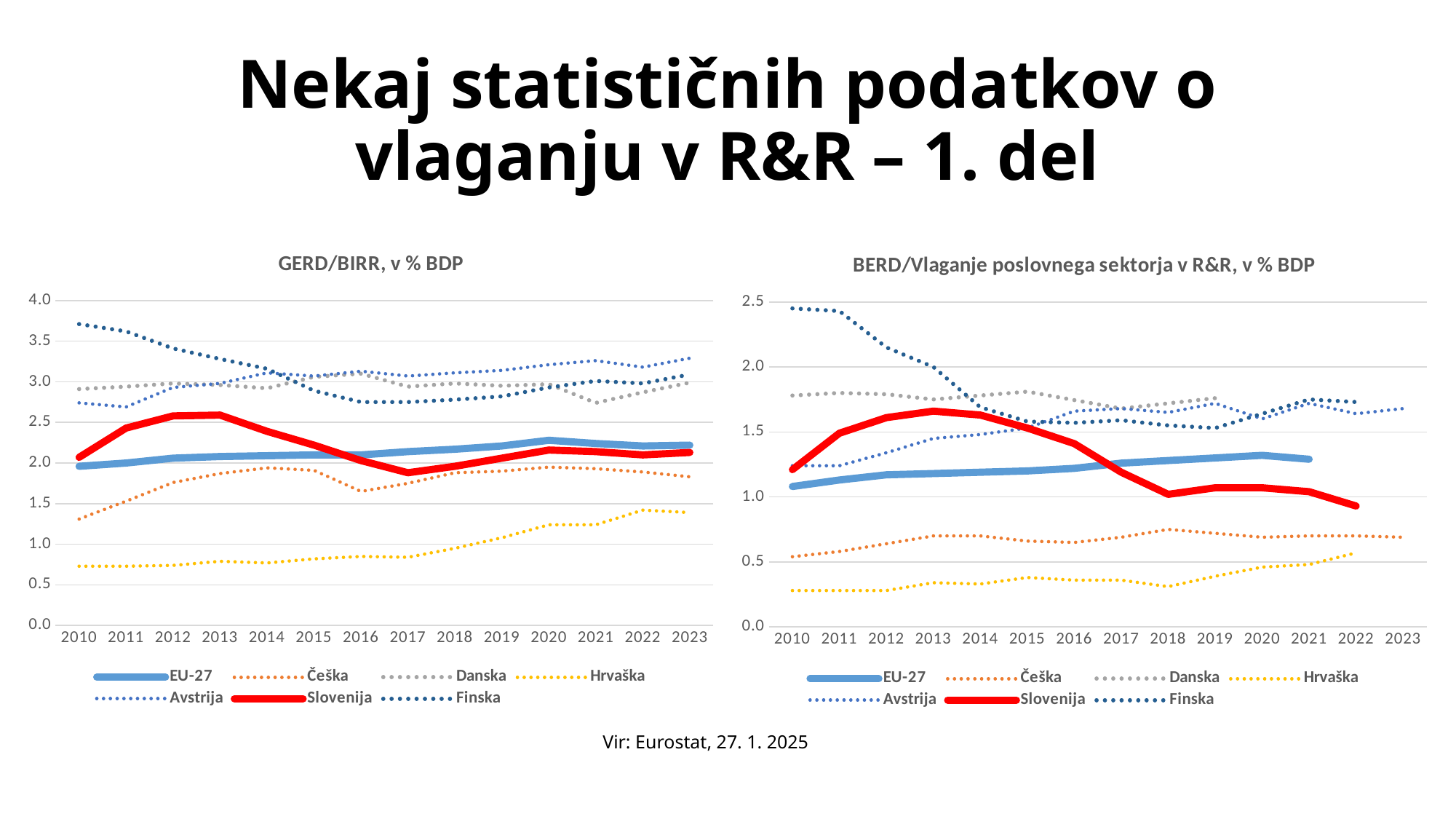
In the BERD chart on the right, which is larger in 2022: Slovenija or Češka? Slovenija In the GERD/BIRR chart on the left, is the value for Hrvaška in 2010 greater or less than 1.0? less What kind of chart is the GERD/BIRR chart on the left? line chart In the BERD chart on the right, is the value for Hrvaška in 2018 greater or less than 0.5? less In the BERD chart on the right, which series has the lowest value in 2010? Hrvaška In the BERD chart on the right, is the value for Finska in 2010 greater or less than 2.0? greater How many series does the legend of the BERD chart on the right list? 7 In the GERD/BIRR chart on the left, does the Finska line rise or fall from 2010 to 2017? fall How many years are shown on the x axis of the GERD/BIRR chart on the left? 14 In the GERD/BIRR chart on the left, which series has the highest value in 2010? Finska What is the title of the chart on the right? BERD/Vlaganje poslovnega sektorja v R&R, v % BDP